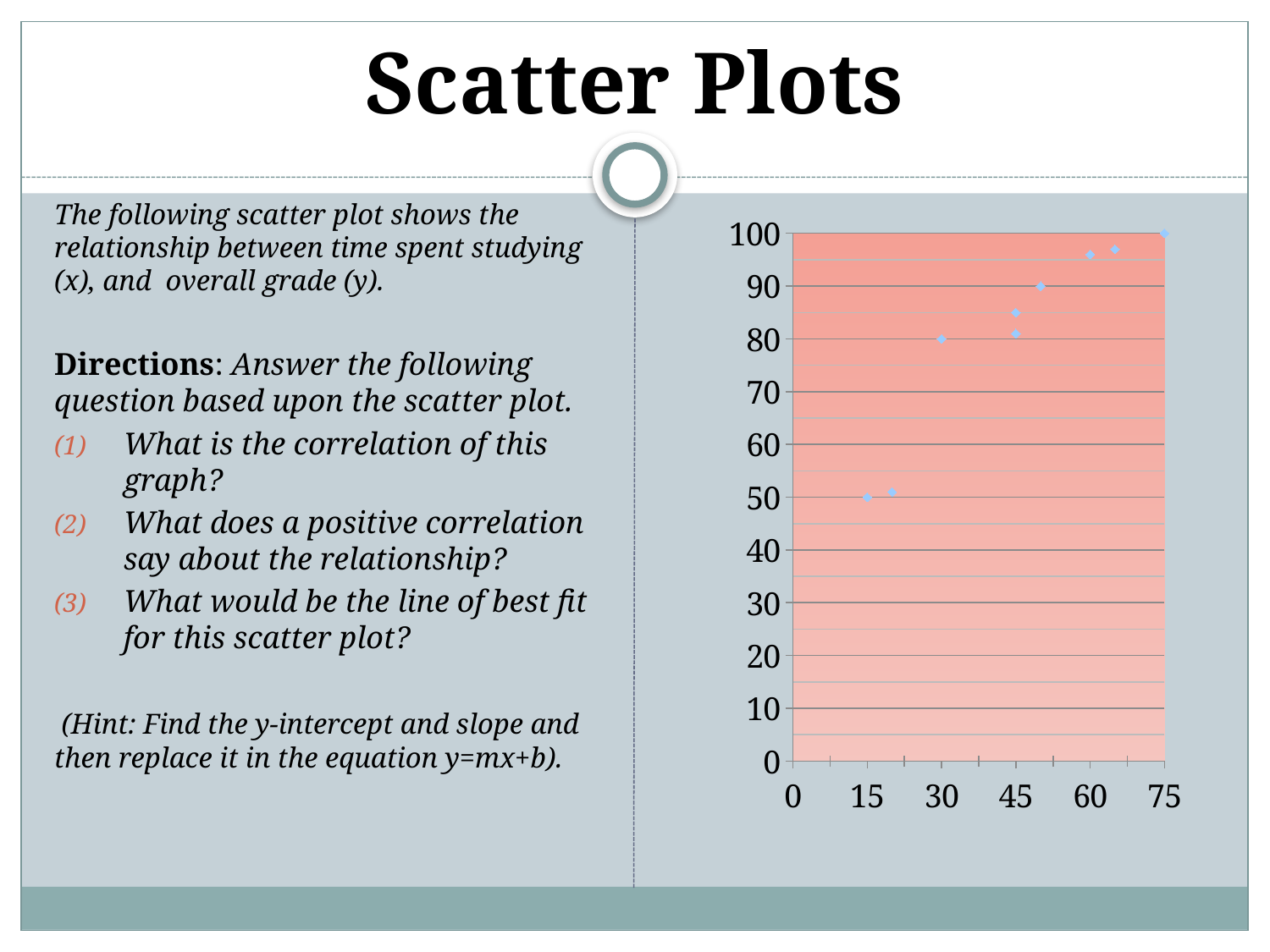
What is the y value of the point at x = 75? 100 Is the y value of the point at x = 30 greater or less than 70? greater What is the highest value labelled on the y axis? 100 Which point has the highest y value: the one at x = 15 or the one at x = 75? x = 75 What kind of chart is shown on the slide? scatter plot Is the y value of the point at x = 60 greater or less than 90? greater What is the highest value labelled on the x axis? 75 How many data points are plotted on the scatter plot? 9 Which point has the lowest y value on the scatter plot? the point at x = 15 Do the plotted values rise or fall as x increases along the x axis? rise Is the y value of the point at x = 15 greater or less than 60? less